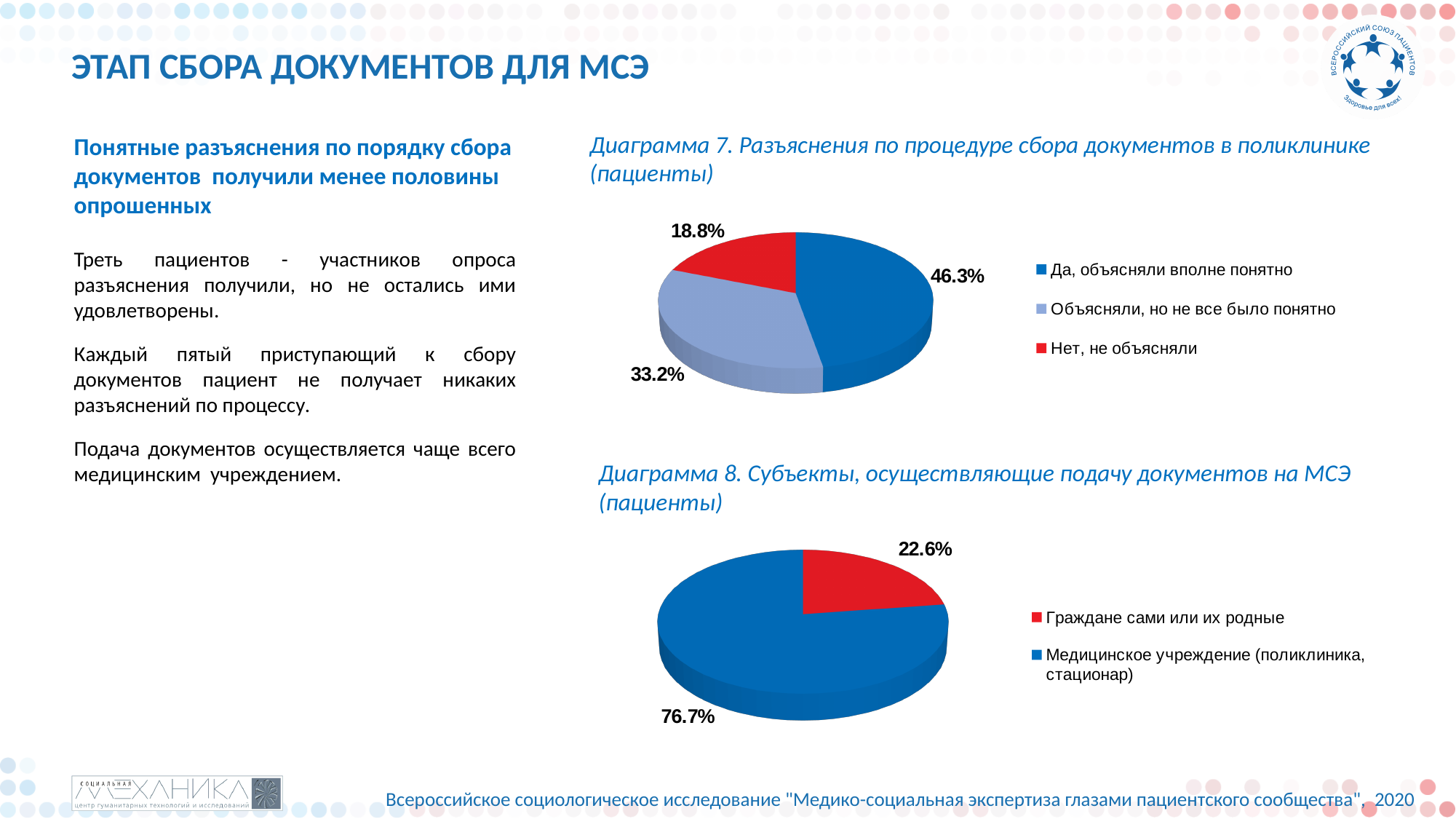
What type of chart is Diagram 8 (Субъекты, осуществляющие подачу документов на МСЭ)? Pie chart In Diagram 7, what is the difference in percentage points between "Да, объясняли вполне понятно" and "Нет, не объясняли"? 27.5 In Diagram 7, which answer option has the largest share? Да, объясняли вполне понятно In Diagram 8, what percentage corresponds to "Граждане сами или их родные"? 22.6% How many entries does the legend of Diagram 8 list? 2 In Diagram 7 (Разъяснения по процедуре сбора документов в поликлинике), what share of patients answered "Да, объясняли вполне понятно"? 46.3% In Diagram 7, what percentage corresponds to "Объясняли, но не все было понятно"? 33.2% In Diagram 7, what percentage of patients said "Нет, не объясняли"? 18.8% In Diagram 8, which is larger: the share for "Граждане сами или их родные" or for "Медицинское учреждение (поликлиника, стационар)"? Медицинское учреждение (поликлиника, стационар) In Diagram 7, which answer option has the smallest share? Нет, не объясняли How many slices does the pie in Diagram 7 have? 3 In Diagram 8, what share of document submissions is made by "Медицинское учреждение (поликлиника, стационар)"? 76.7%